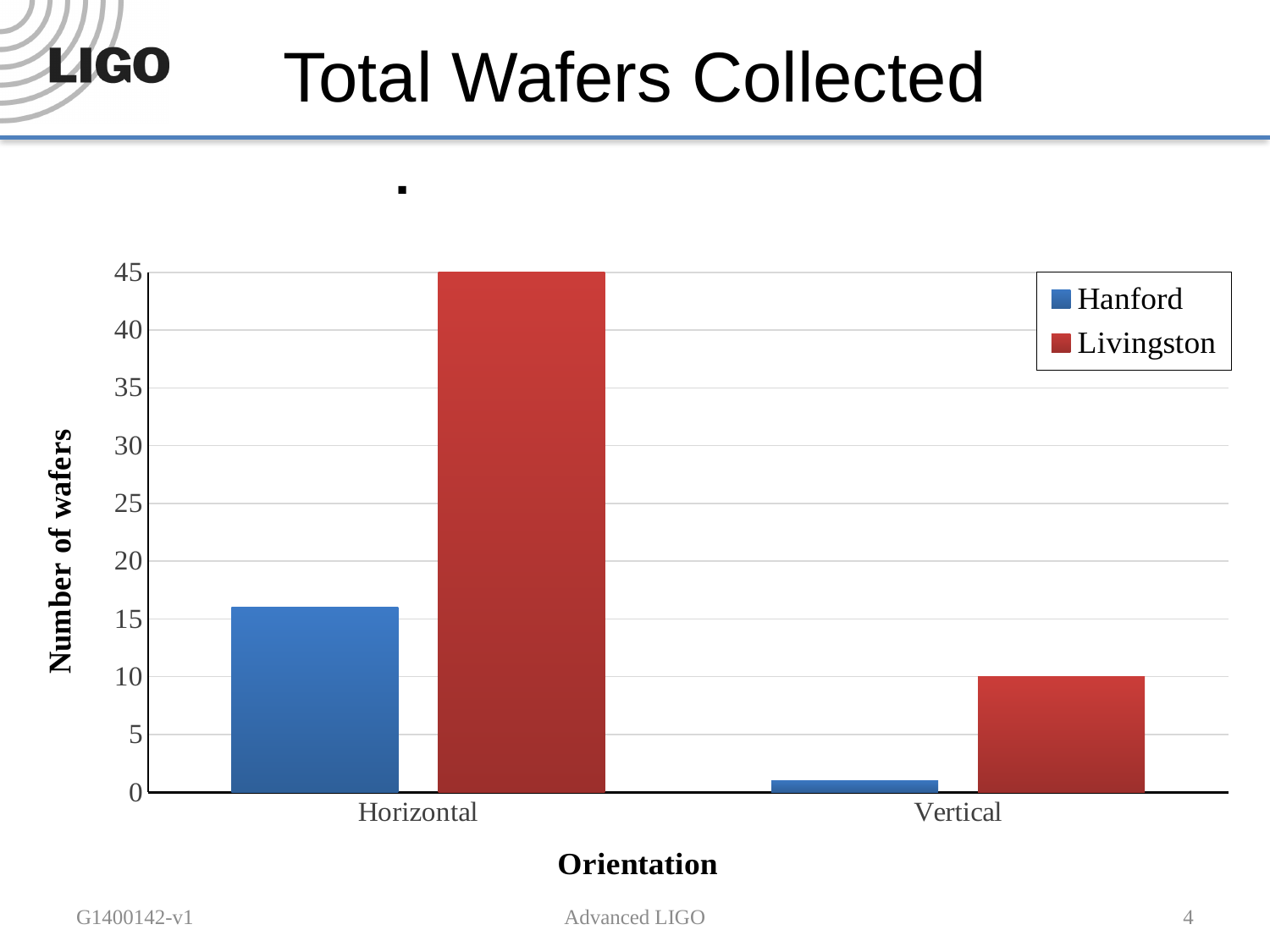
How many orientation categories are shown on the x axis? 2 Is the number of Vertical wafers for Hanford greater or less than 5? less Which site collected more Horizontal wafers, Hanford or Livingston? Livingston What is the number of wafers for Livingston in the Horizontal orientation? 45 What is the label of the y axis? Number of wafers What is the number of wafers for Livingston in the Vertical orientation? 10 What is the difference between Livingston's Horizontal and Vertical wafer counts? 35 Which bar is the highest in the chart? Livingston, Horizontal How many series does the legend list? 2 Which bar is the lowest in the chart? Hanford, Vertical What kind of chart is shown on the slide? bar chart Is the number of Horizontal wafers for Hanford greater or less than 20? less